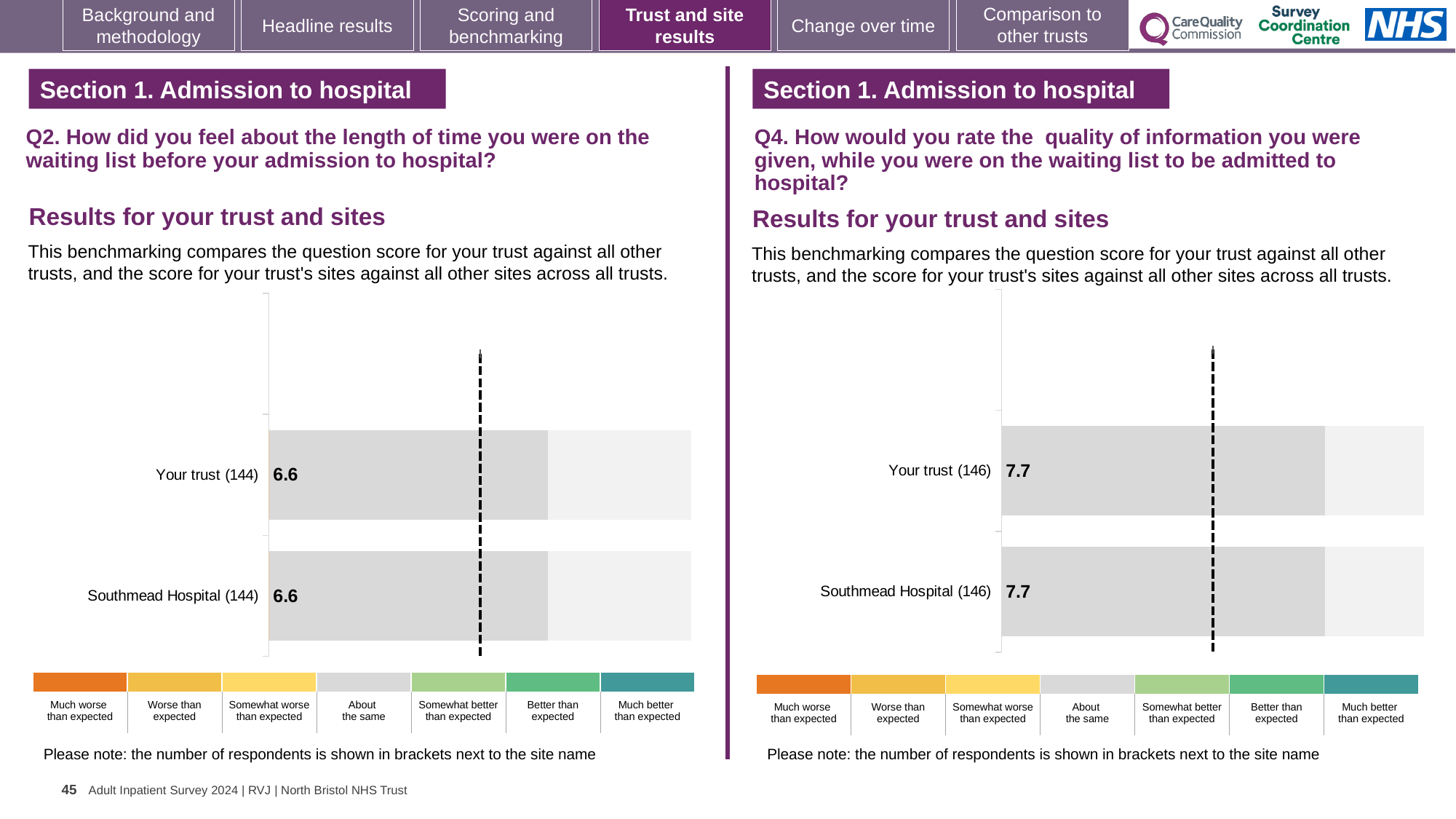
In the right chart (Q4), what is the score for Your trust? 7.7 In the left chart (Q2), what is the score for Your trust? 6.6 In the left chart (Q2), what is the difference between the score for Your trust and the score for Southmead Hospital? 0 What kind of chart is used on the left side of the slide (Q2)? Bar chart In the left chart (Q2), how many respondents are shown in brackets for Southmead Hospital? 144 In the right chart (Q4), what is the score for Southmead Hospital? 7.7 In the left chart (Q2), what is the score for Southmead Hospital? 6.6 Is the score for Your trust in the right chart (Q4) greater or less than the score for Your trust in the left chart (Q2)? greater How many bars are plotted in the left chart (Q2)? 2 In the right chart (Q4), how many respondents are shown in brackets for Your trust? 146 How many bars are plotted in the right chart (Q4)? 2